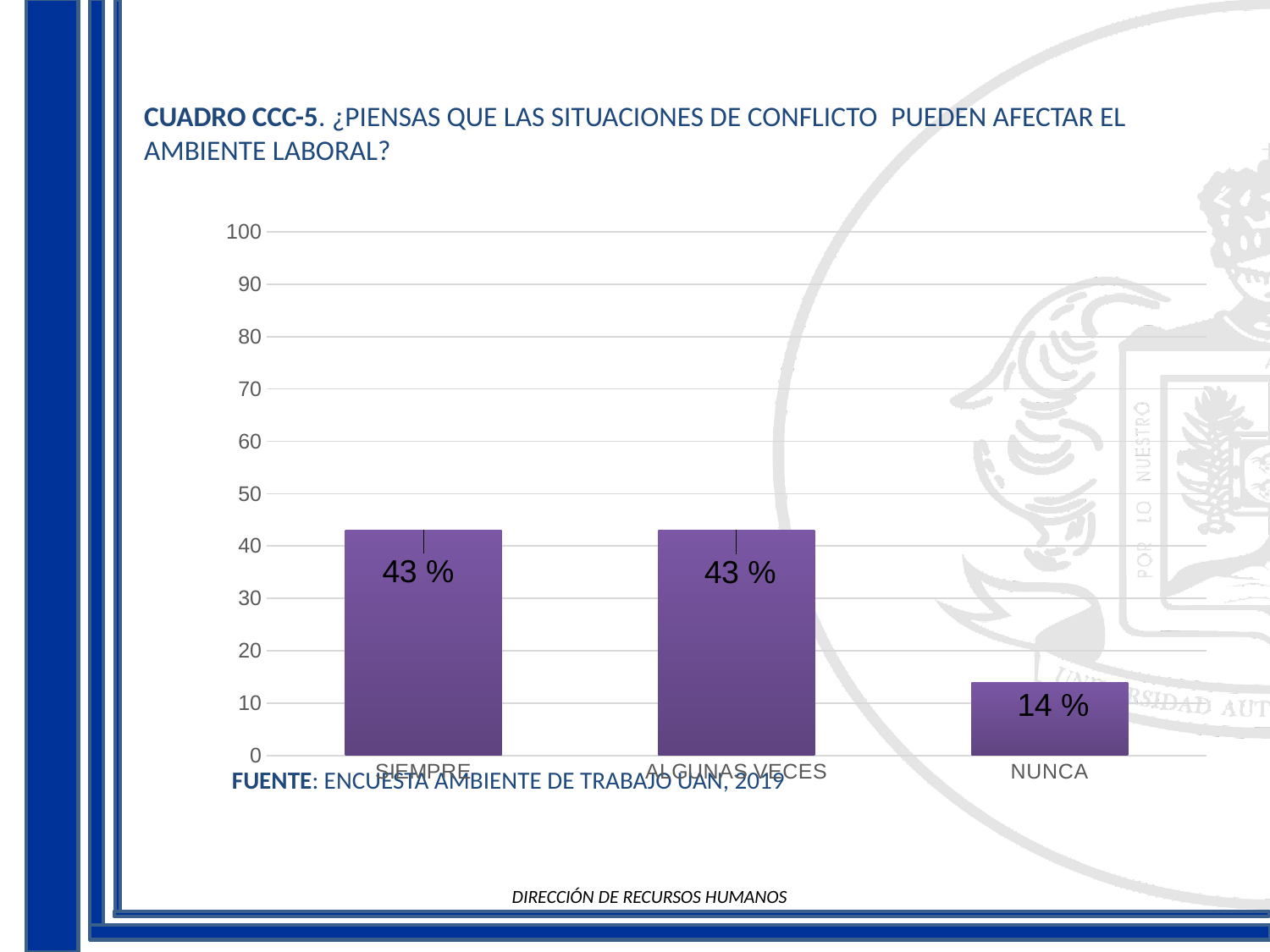
Which category has the lowest value? NUNCA Do the values rise or fall from ALGUNAS VECES to NUNCA? fall Is the value for SIEMPRE greater or less than 40? greater Is the value for NUNCA greater or less than 20? less How many categories are shown on the x axis? 3 What is the value for ALGUNAS VECES? 43 % What kind of chart is shown on the slide? bar chart What is the difference between the values for SIEMPRE and NUNCA? 29 % What is the value for SIEMPRE? 43 % What is the value for NUNCA? 14 % Which is larger, the value for ALGUNAS VECES or the value for NUNCA? ALGUNAS VECES What is the source cited below the chart? ENCUESTA AMBIENTE DE TRABAJO UAN, 2019